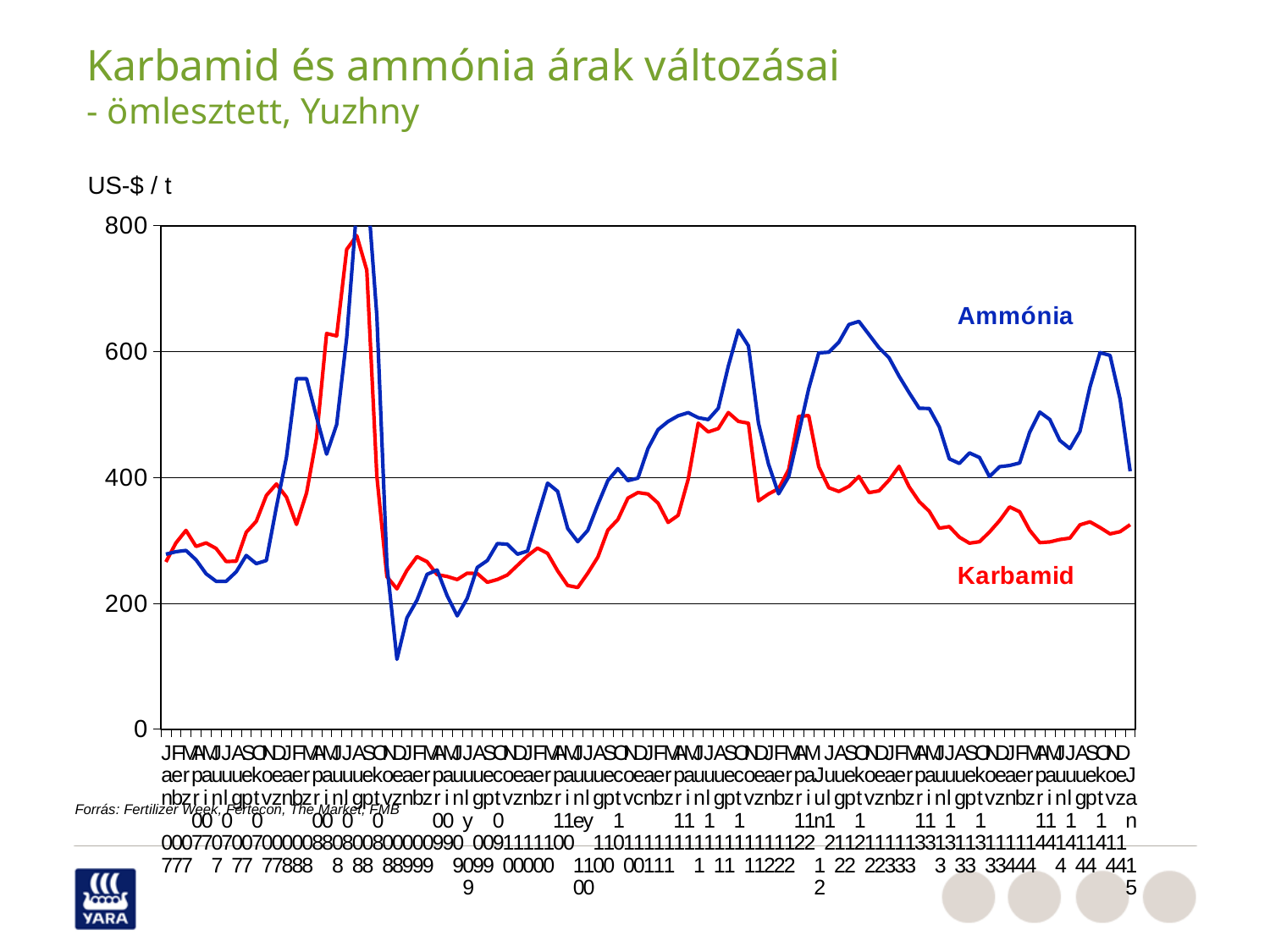
How many series are plotted on the chart? 2 At the right-hand end of the chart, which series has the higher value, Ammónia or Karbamid? Ammónia Which series drops to the lower minimum value on the chart, Ammónia or Karbamid? Ammónia Over the last few points of the chart, does the Ammónia series rise or fall? fall Is the final value of the Karbamid series greater or less than 400? less Is the lowest value reached by the Ammónia series greater or less than 200? less Is the highest value reached by the Ammónia series greater or less than 600? greater What are the names of the two series plotted on the chart? Ammónia and Karbamid What kind of chart is shown on the slide? line chart What unit is shown for the y axis of the chart? US-$ / t